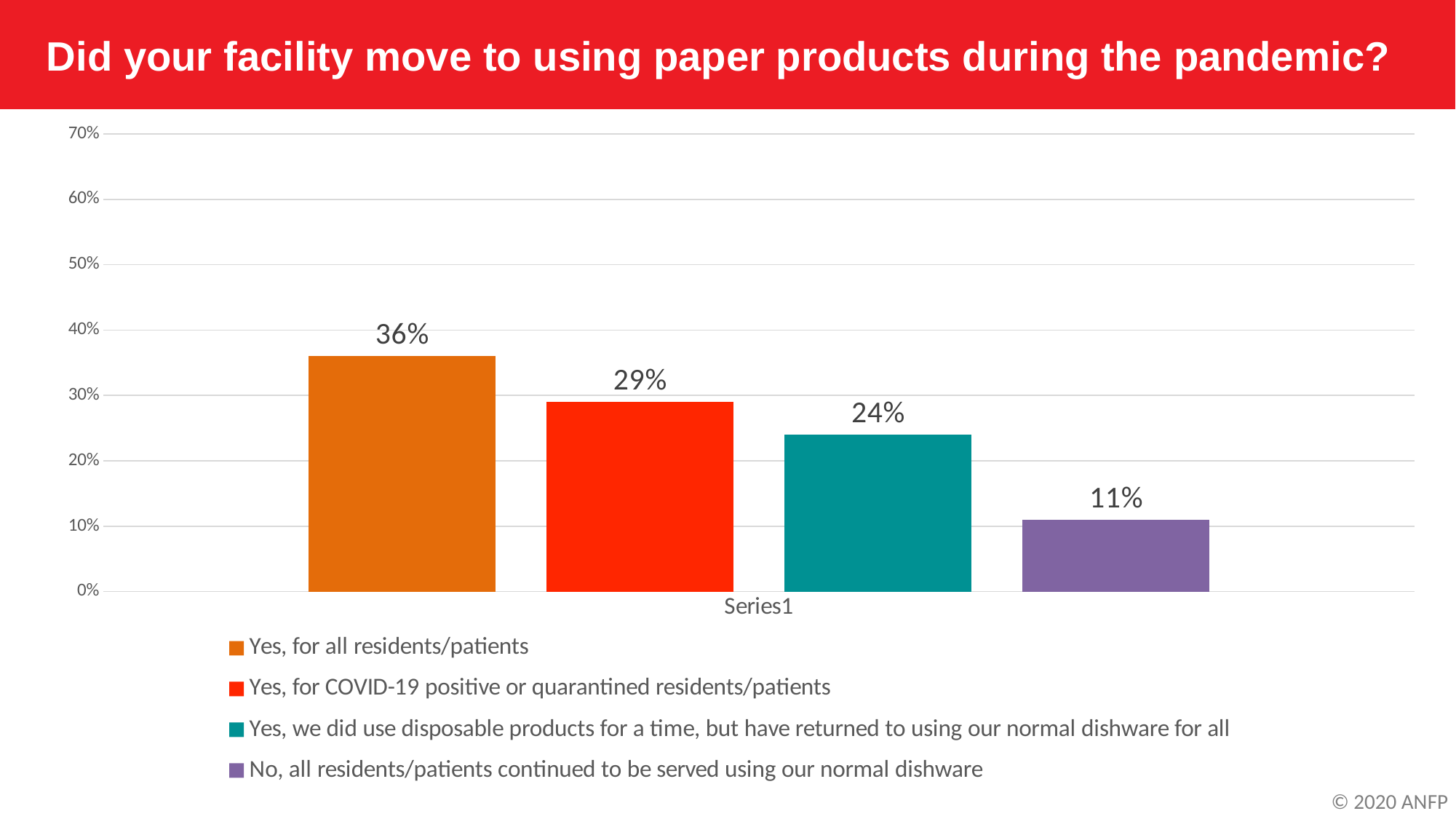
What is the difference in percentage points between 'Yes, for all residents/patients' and 'Yes, for COVID-19 positive or quarantined residents/patients'? 7 percentage points What percentage said they used disposable products for a time but have returned to normal dishware for all? 24% What percentage said all residents/patients continued to be served using normal dishware? 11% Which response has the highest percentage? Yes, for all residents/patients Which is larger: the percentage for 'Yes, we did use disposable products for a time, but have returned to using our normal dishware for all' or for 'No, all residents/patients continued to be served using our normal dishware'? Yes, we did use disposable products for a time, but have returned to using our normal dishware for all What type of chart is shown on the slide? Bar chart How many response categories are shown in the chart? 4 What percentage of respondents said their facility used paper products for COVID-19 positive or quarantined residents/patients? 29% What percentage of respondents said their facility moved to paper products for all residents/patients? 36% What is the title of the chart on the slide? Did your facility move to using paper products during the pandemic? How many entries does the legend list? 4 Which response has the lowest percentage? No, all residents/patients continued to be served using our normal dishware